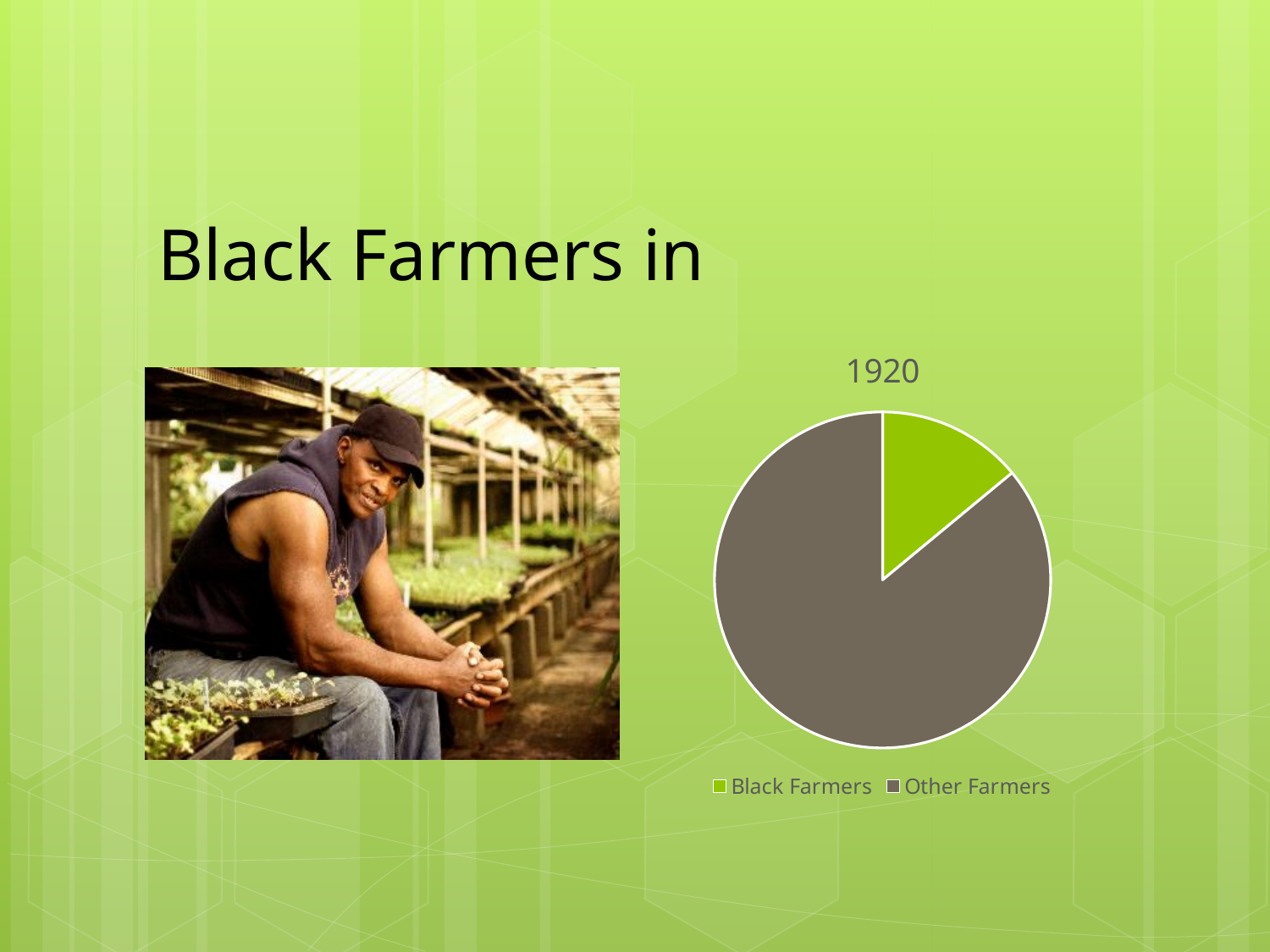
What is the title of the pie chart? 1920 Is the Other Farmers slice more or less than half of the pie? more Which category has the smallest slice in the pie chart? Black Farmers Is the Black Farmers slice more or less than half of the pie? less How many slices does the pie chart have? 2 What colour is the Black Farmers slice in the pie chart? green What kind of chart is shown on the slide? pie chart Which category has the largest slice in the pie chart? Other Farmers How many entries does the legend of the pie chart list? 2 In the pie chart, which slice is larger: Black Farmers or Other Farmers? Other Farmers